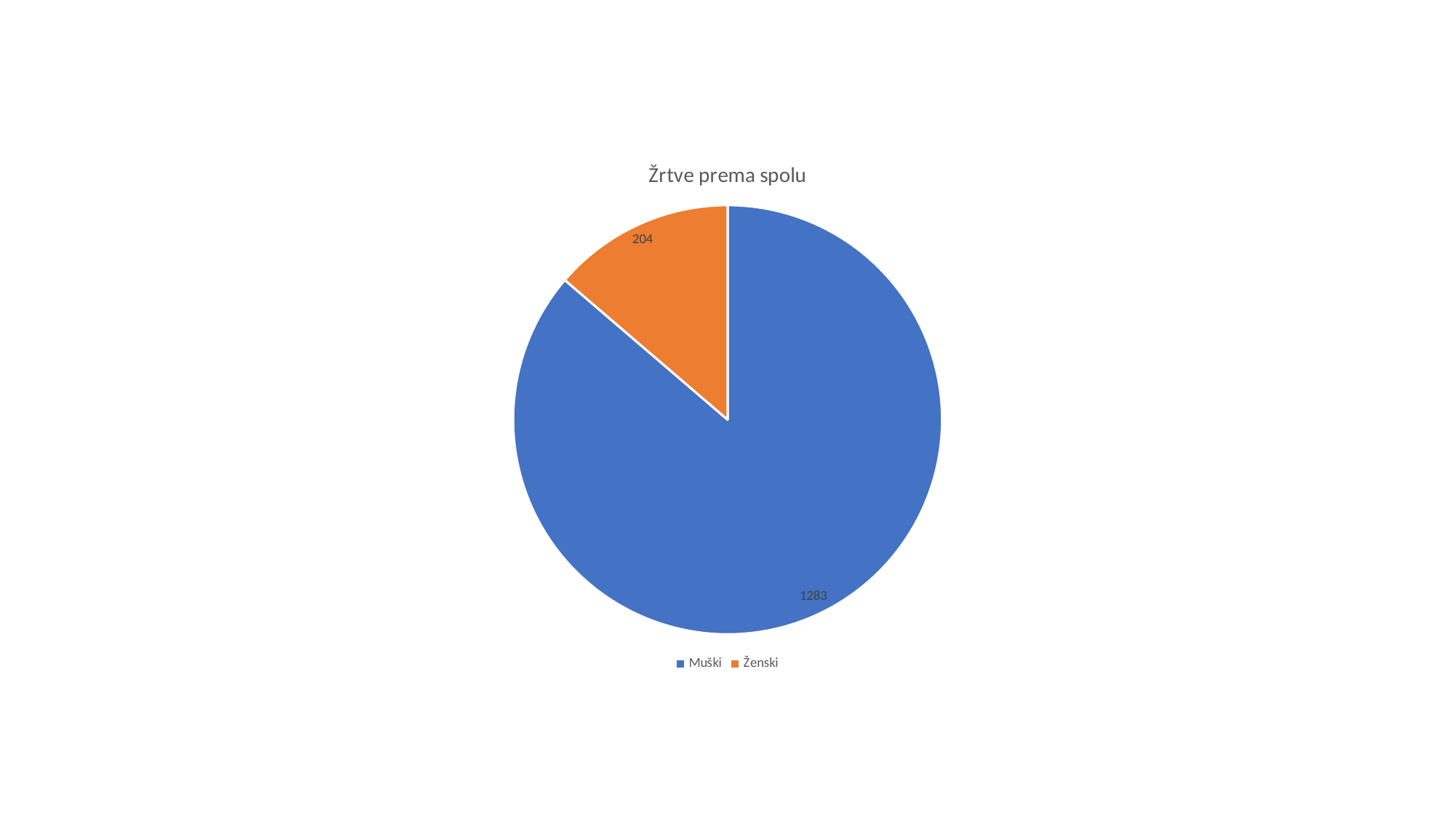
What is the value for Muški? 1283 How many entries does the legend list? 2 What is the total of all slices in the pie chart? 1487 Which is larger, the value for Muški or the value for Ženski? Muški What colour is the Ženski slice? Orange What kind of chart is shown on the slide? Pie chart What is the difference between the values for Muški and Ženski? 1079 Which category has the smallest slice? Ženski What is the title of the chart? Žrtve prema spolu What is the value for Ženski? 204 How many slices does the pie chart have? 2 Which category has the largest slice? Muški